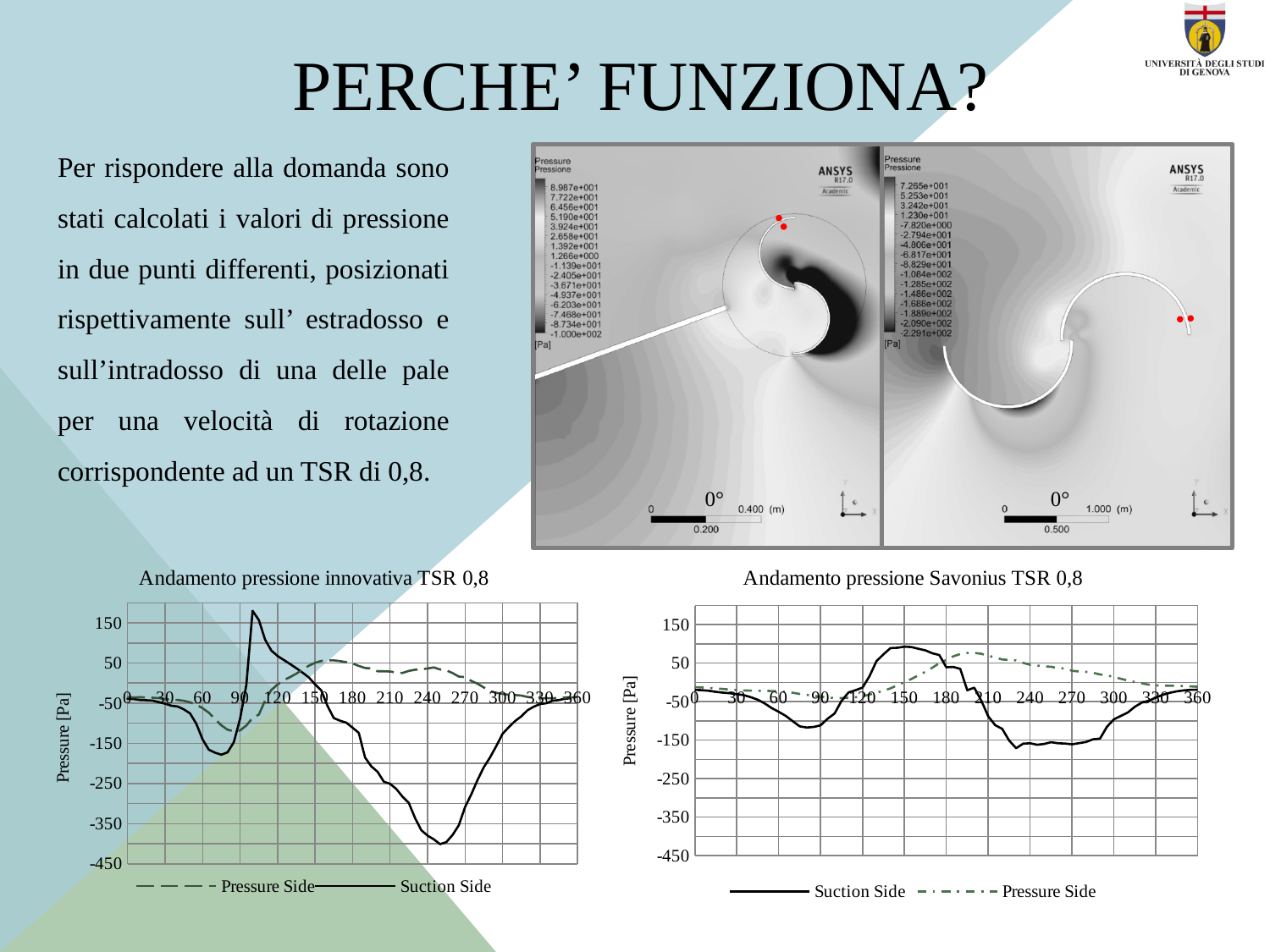
What are the two series named in the legend of "Andamento pressione innovativa TSR 0,8"? Pressure Side and Suction Side In "Andamento pressione innovativa TSR 0,8", does the Suction Side series rise or fall between 150 and 240 on the x axis? fall What kind of chart is "Andamento pressione innovativa TSR 0,8"? line chart In "Andamento pressione innovativa TSR 0,8", is the peak value of the Suction Side series greater or less than 150? greater In "Andamento pressione innovativa TSR 0,8", which series reaches the lowest value? Suction Side In "Andamento pressione Savonius TSR 0,8", is the peak value of the Suction Side series greater or less than 50? greater How many series does the legend of "Andamento pressione Savonius TSR 0,8" list? 2 In "Andamento pressione Savonius TSR 0,8", is the lowest value of the Suction Side series greater or less than -50? less How many tick labels are shown on the x axis of "Andamento pressione Savonius TSR 0,8"? 13 What is the y-axis label on the "Andamento pressione Savonius TSR 0,8" chart? Pressure [Pa] Which chart's Suction Side series reaches a lower minimum, "Andamento pressione innovativa TSR 0,8" or "Andamento pressione Savonius TSR 0,8"? Andamento pressione innovativa TSR 0,8